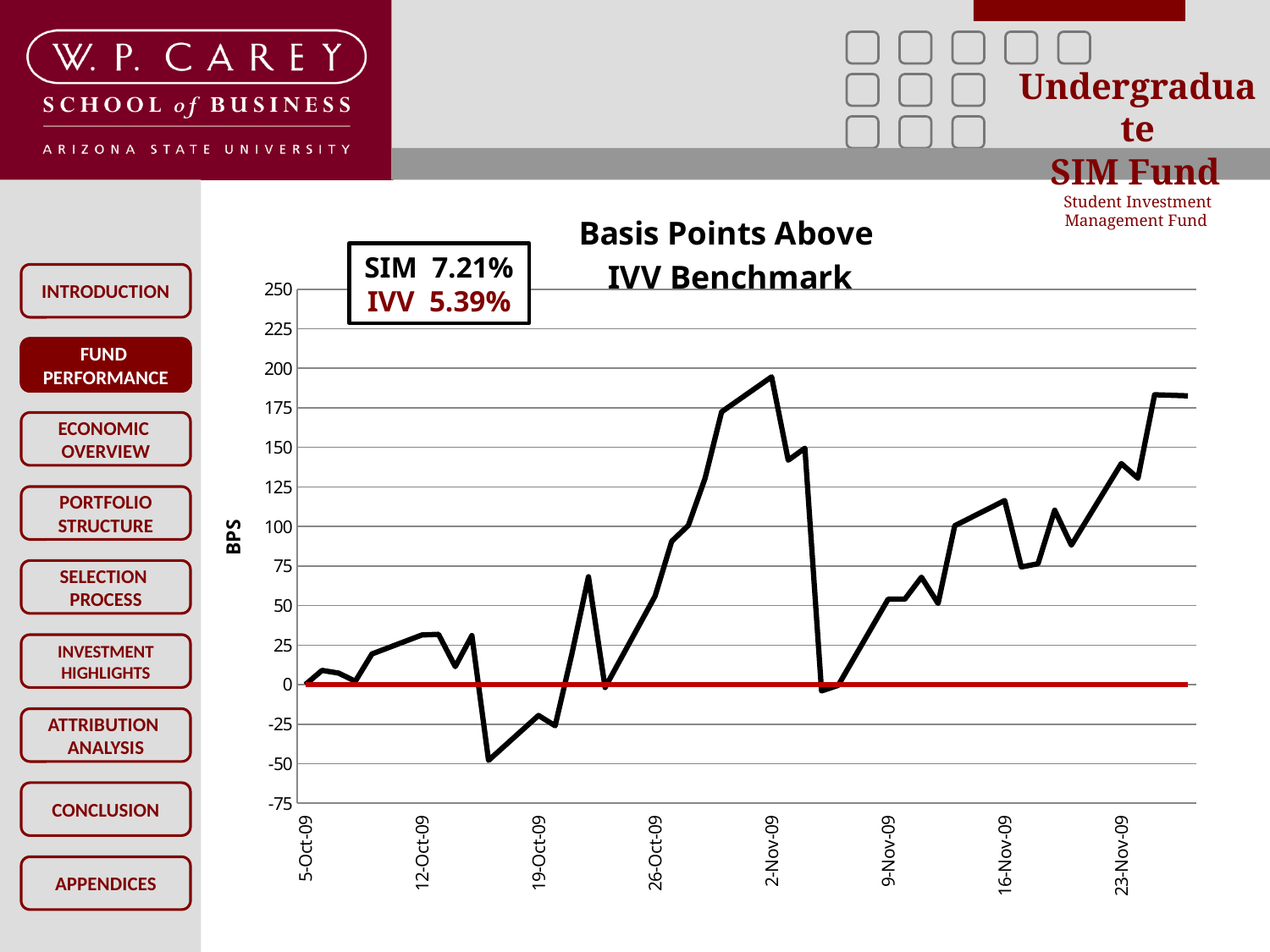
Is the value of the line at 5-Oct-09 greater or less than 25? less How many date labels are shown along the x axis of the chart? 8 What return is shown for IVV in the text box on the chart? 5.39% What is the label on the vertical axis of the chart? BPS Which is larger, the value of the line at 2-Nov-09 or at 9-Nov-09? 2-Nov-09 What return is shown for SIM in the text box on the chart? 7.21% Does the line end higher or lower than it starts? higher What is the title of the chart? Basis Points Above IVV Benchmark Is the lowest value of the line, reached between 12-Oct-09 and 19-Oct-09, greater or less than -25? less Is the value of the line at 23-Nov-09 greater or less than 100? greater What kind of chart is shown on the slide? line chart